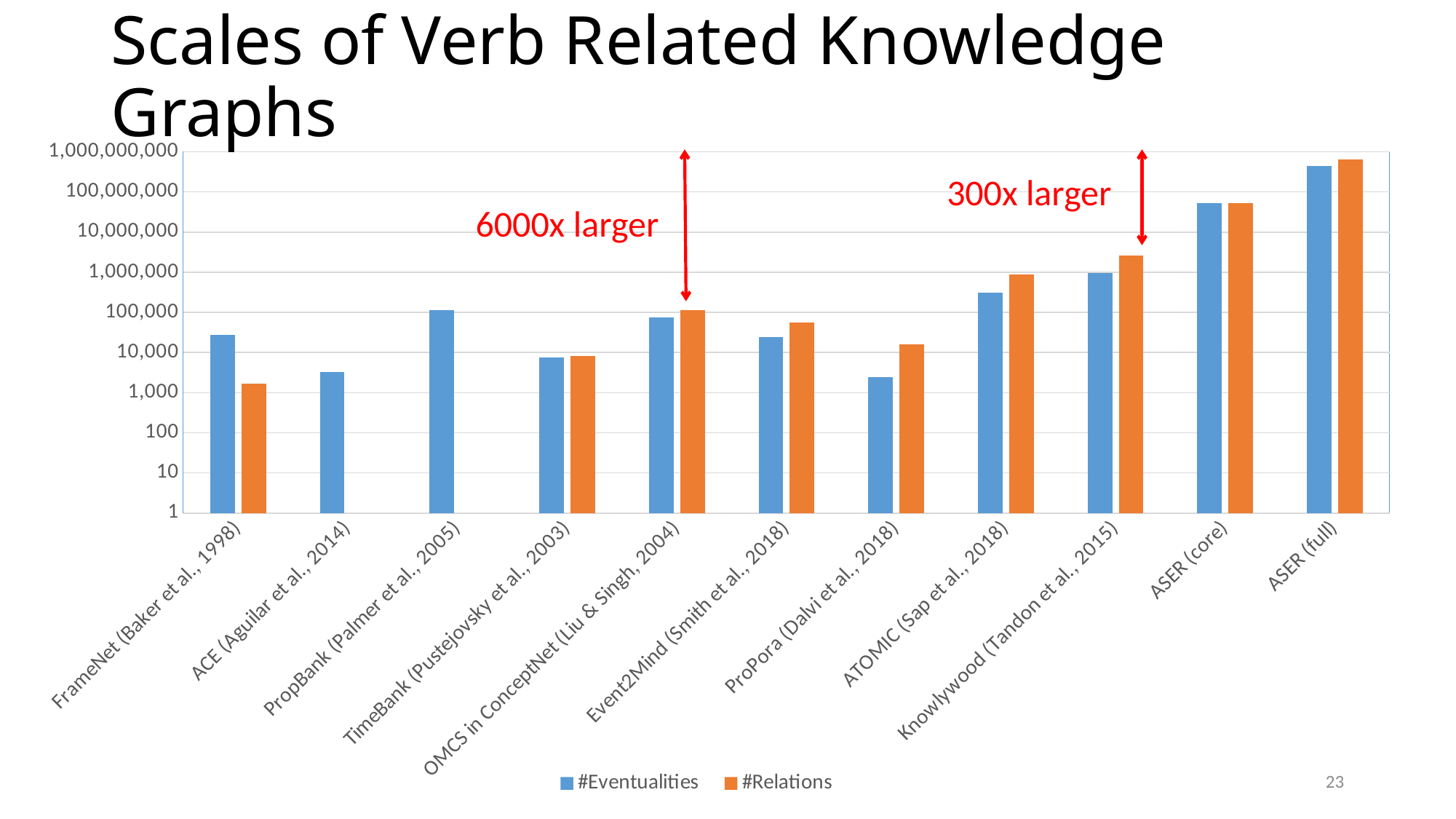
How many knowledge graphs (categories) are shown on the x axis? 11 How many series does the legend list? 2 Among the knowledge graphs with a #Relations bar, which has the lowest #Relations value? FrameNet (Baker et al., 1998) What kind of chart is shown on the slide? bar chart Which knowledge graph has the highest #Relations value? ASER (full) For ATOMIC (Sap et al., 2018), which is larger: #Eventualities or #Relations? #Relations Which knowledge graph has the highest #Eventualities value? ASER (full) Is the #Relations value for Knowlywood (Tandon et al., 2015) greater or less than 1,000,000? greater What annotation is written next to the red arrow above OMCS in ConceptNet (Liu & Singh, 2004)? 6000x larger For FrameNet (Baker et al., 1998), which is larger: #Eventualities or #Relations? #Eventualities Is the #Eventualities value for ACE (Aguilar et al., 2014) greater or less than 10,000? less